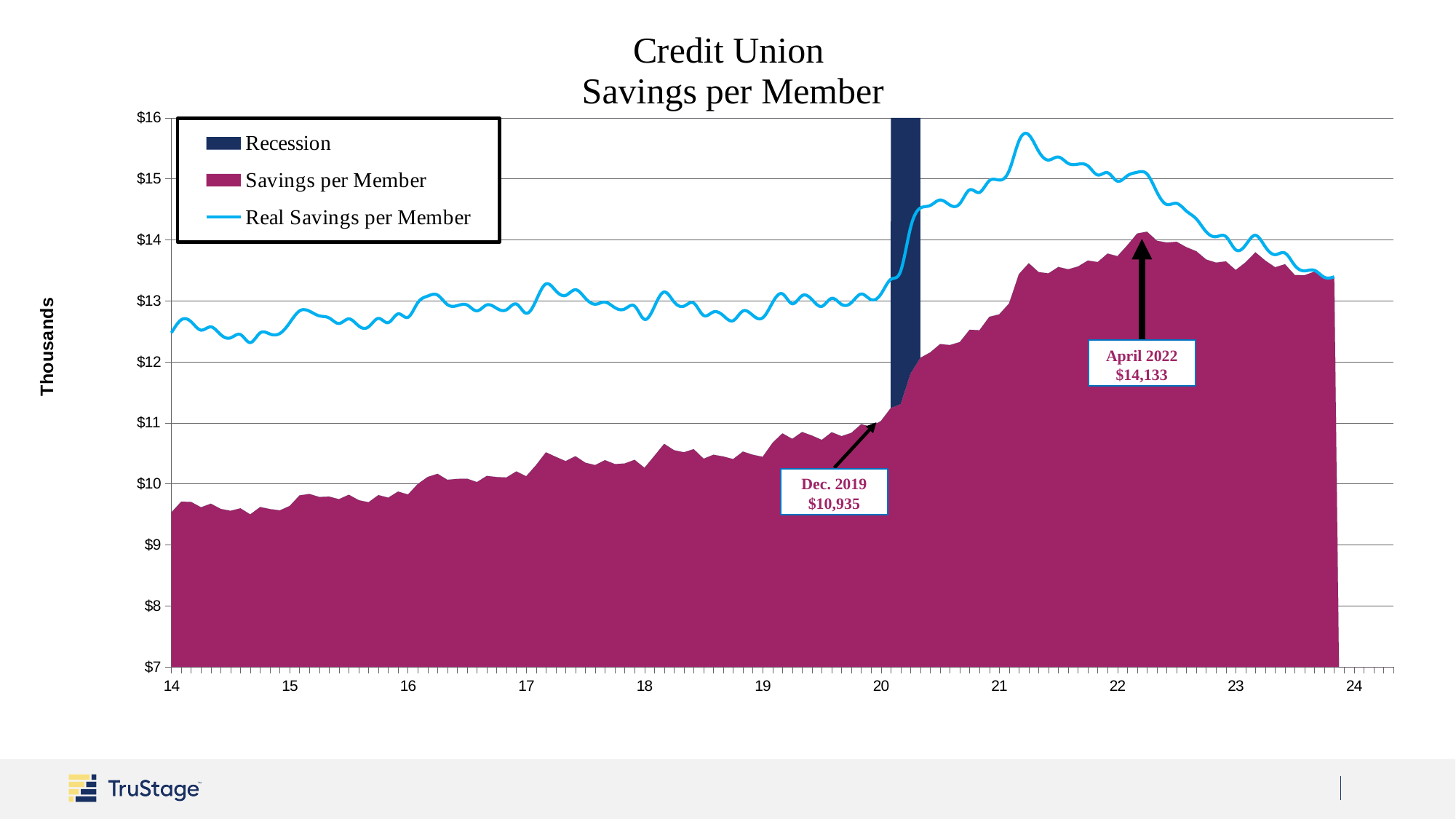
What is the label on the vertical axis? Thousands What is the title of the chart? Credit Union Savings per Member What is the difference between the annotated April 2022 value and the annotated Dec. 2019 value? $3,198 Is the peak of Real Savings per Member in 2021 greater or less than $15 thousand? greater Is the Savings per Member value at the start of 2014 greater or less than $10 thousand? less What kind of chart is this? Area chart with a line series Does Savings per Member rise or fall from 2014 to 2022? Rise Which of the two annotated points, Dec. 2019 or April 2022, has the higher Savings per Member value? April 2022 At the start of 2014, which is larger: Real Savings per Member or Savings per Member? Real Savings per Member How many series does the legend list? 3 What is the Savings per Member value annotated for Dec. 2019? $10,935 What is the Savings per Member value annotated for April 2022? $14,133